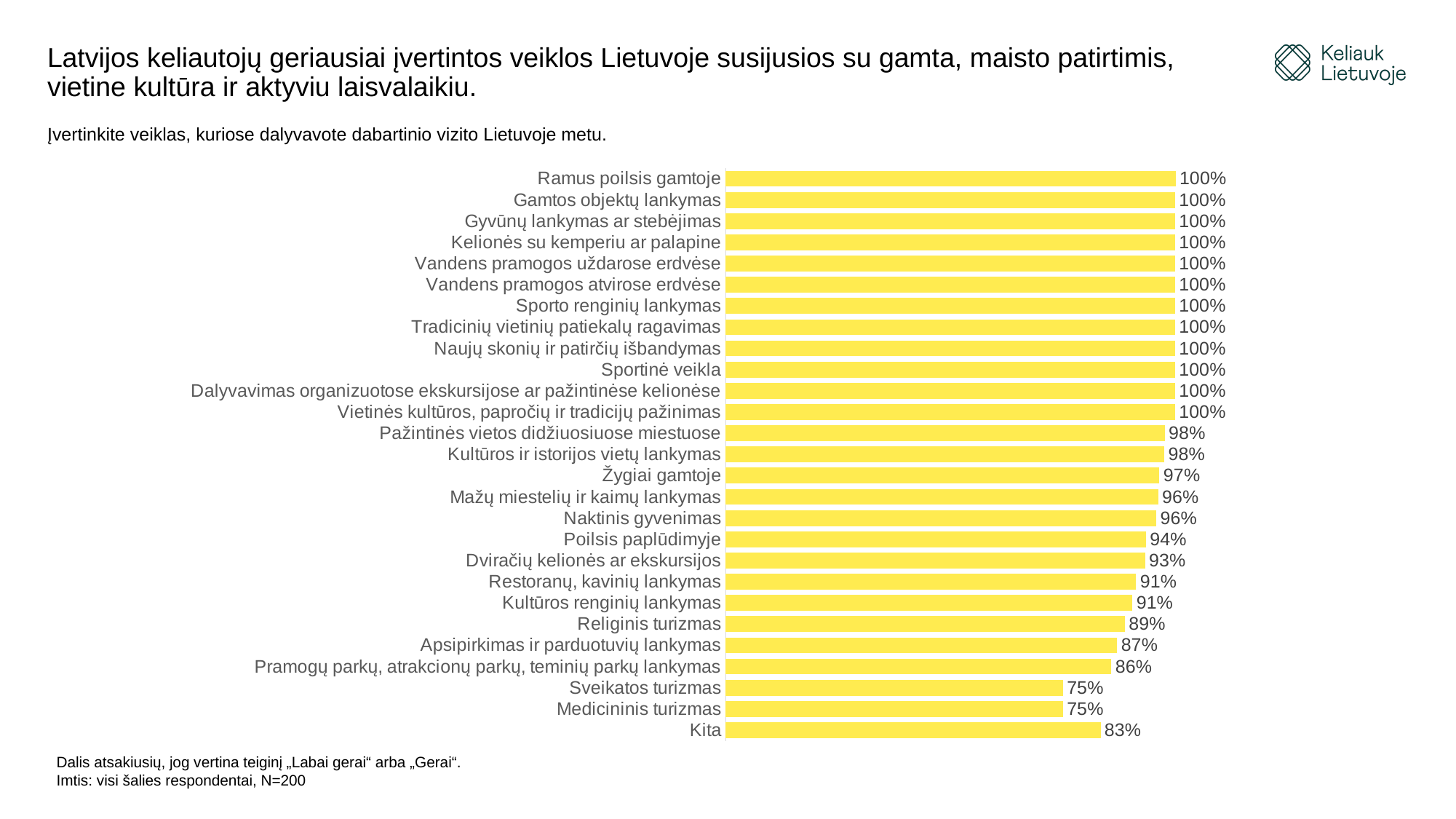
What is the value for Žygiai gamtoje? 97% What is the value for Religinis turizmas? 89% What is the highest value shown in the chart? 100% What colour are the bars in the chart? Yellow What kind of chart is shown on the slide? Bar chart What is the lowest value shown in the chart? 75% What is the difference between the values for Dviračių kelionės ar ekskursijos and Apsipirkimas ir parduotuvių lankymas? 6% What is the value for Kita? 83% Which is larger, the value for Naktinis gyvenimas or the value for Pramogų parkų, atrakcionų parkų, teminių parkų lankymas? Naktinis gyvenimas What is the value for Poilsis paplūdimyje? 94% How many categories are shown in the chart? 27 What is the difference between the values for Pažintinės vietos didžiuosiuose miestuose and Sveikatos turizmas? 23%